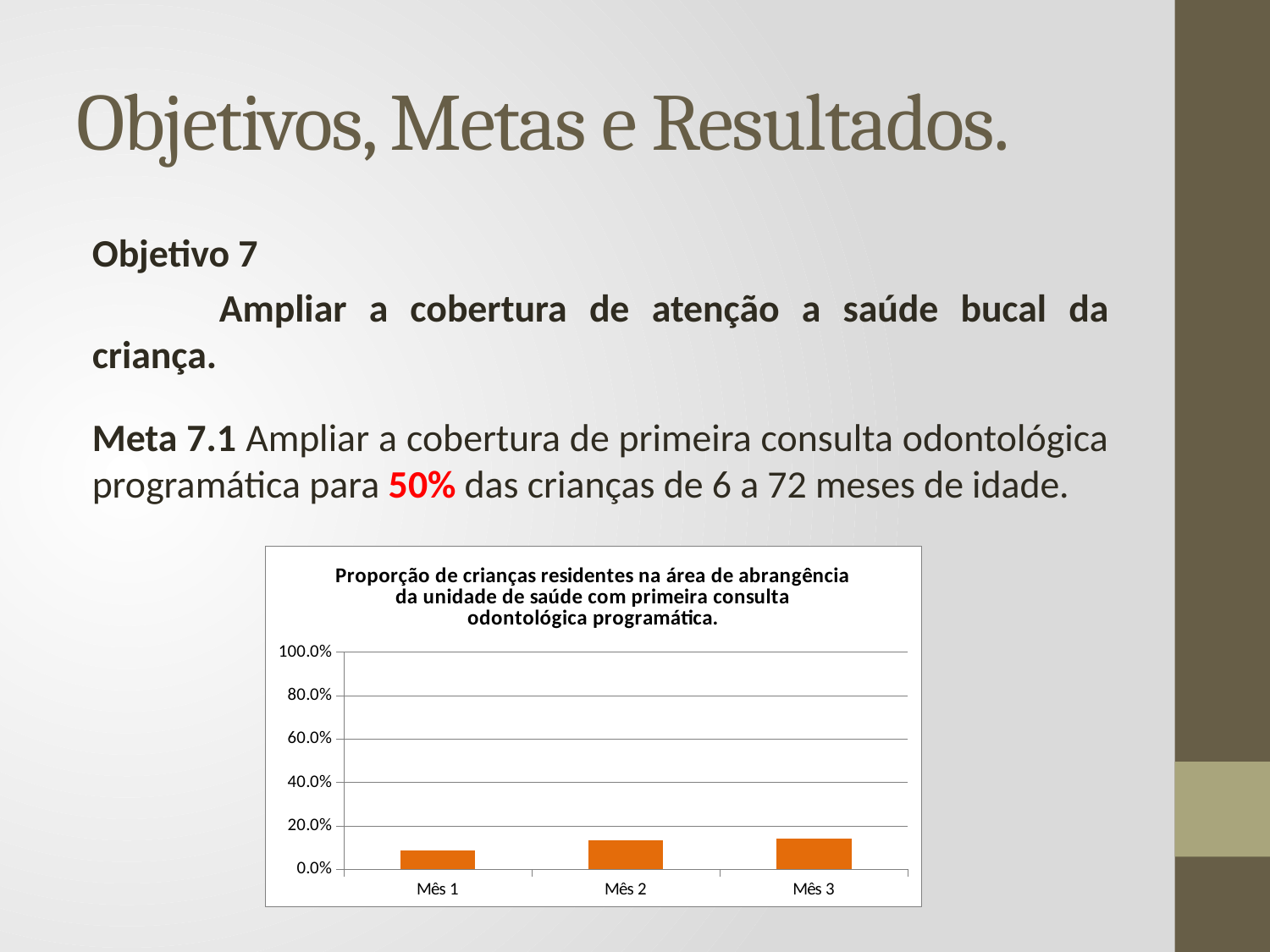
Is the value for Mês 3 greater or less than 20.0%? less What kind of chart is shown on the slide? bar chart Is the value for Mês 2 greater or less than 20.0%? less Which is larger, the value for Mês 1 or the value for Mês 3? Mês 3 Is the value for Mês 3 greater or less than 40.0%? less Do the values rise or fall from Mês 1 to Mês 3? rise What is the title of the chart? Proporção de crianças residentes na área de abrangência da unidade de saúde com primeira consulta odontológica programática. What is the highest value shown on the y axis of the chart? 100.0% How many categories are shown on the x axis of the chart? 3 Which is larger, the value for Mês 1 or the value for Mês 2? Mês 2 Which month has the lowest value in the chart? Mês 1